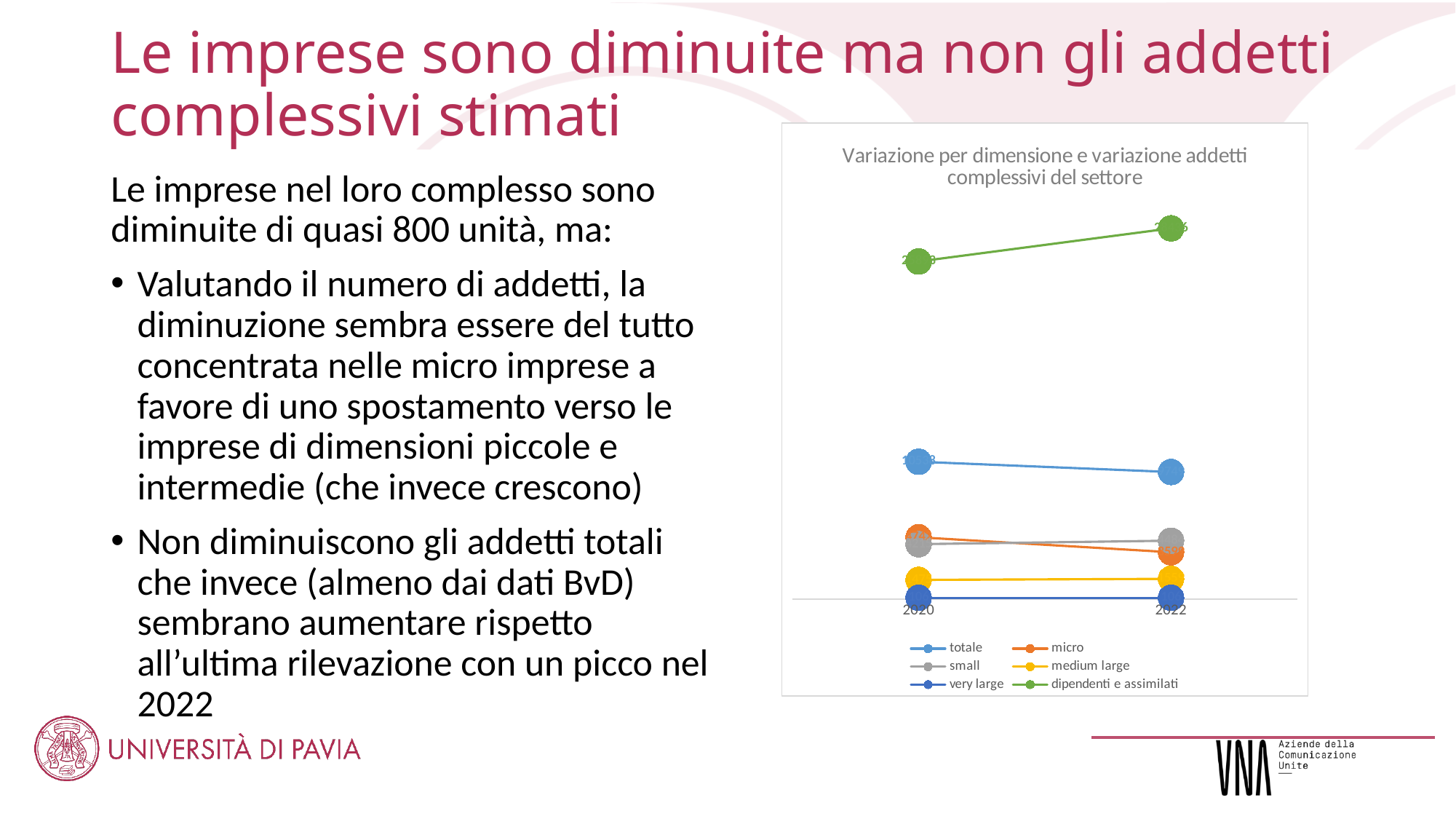
In 2020, which is larger: the value for 'totale' or the value for 'micro'? totale Does the 'dipendenti e assimilati' series rise or fall from 2020 to 2022? rise Does the 'totale' series rise or fall from 2020 to 2022? fall How many points are shown on the x axis of the chart? 2 What kind of chart is shown on the slide? line chart Does the 'micro' series rise or fall from 2020 to 2022? fall Which series has the highest value in 2022? dipendenti e assimilati What is the title of the chart? Variazione per dimensione e variazione addetti complessivi del settore How many series does the chart legend list? 6 In 2022, which is larger: the value for 'small' or the value for 'micro'? small Which series has the lowest value in 2020? very large Which years are shown on the x axis of the chart? 2020 and 2022